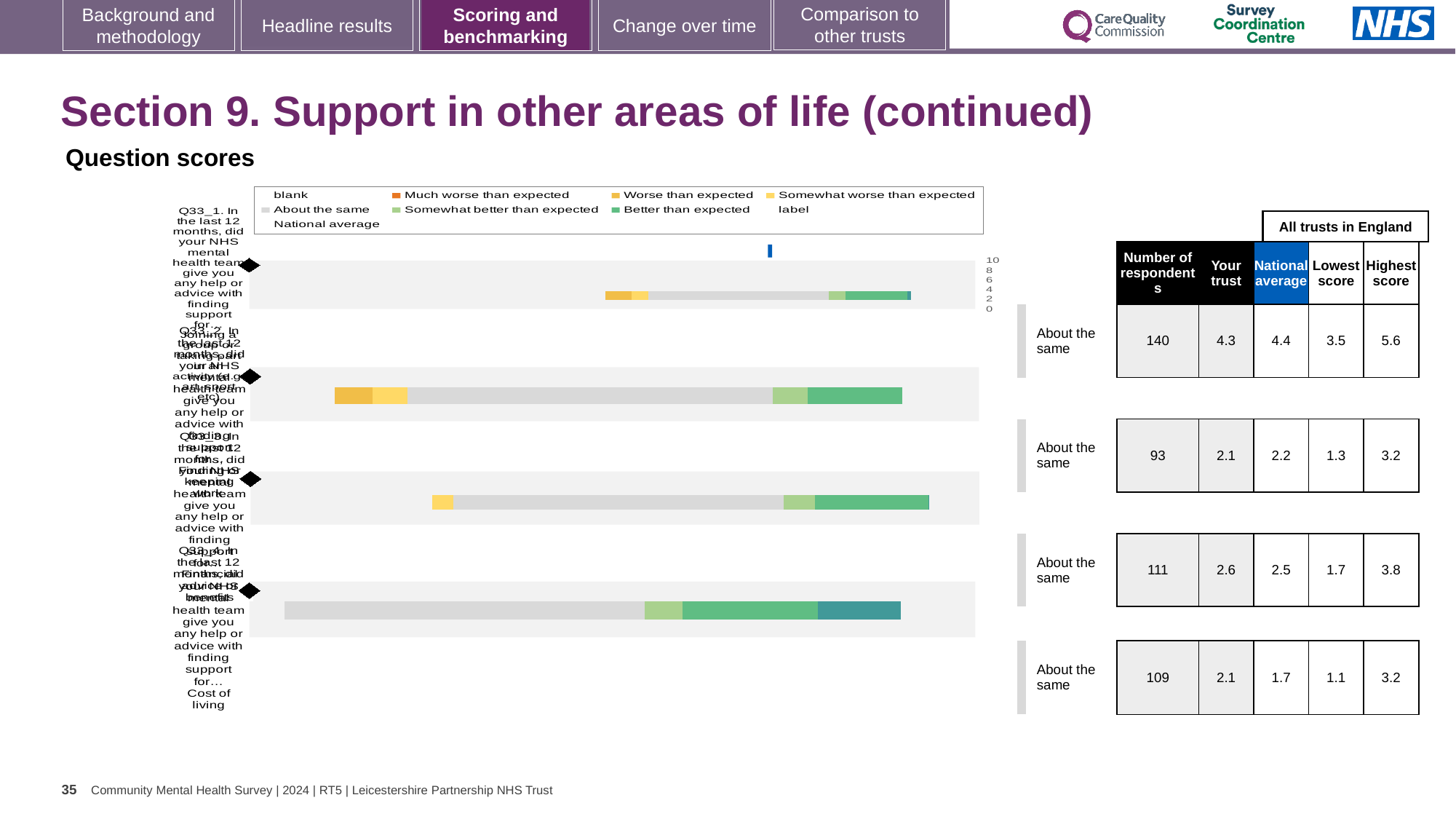
What benchmark label is shown beside each of the four bars? About the same What kind of chart is shown under 'Question scores'? bar chart Which legend entry is shown in light grey? About the same In the table beside the chart, what is the number of respondents for the first row (Q33_1)? 140 In the table beside the chart, is the 'Your trust' score for the third row (111 respondents) larger or smaller than its national average? larger In the table beside the chart, which row has the highest 'Your trust' score? Q33_1 (4.3) In the table beside the chart, what is the 'Your trust' score for the last row (Q33_4, Cost of living)? 2.1 In the table beside the chart, what is the difference between the 'Your trust' score and the national average for the last row (Q33_4)? 0.4 Which legend entry is shown in dark orange? Much worse than expected How many question bars are plotted in the chart? 4